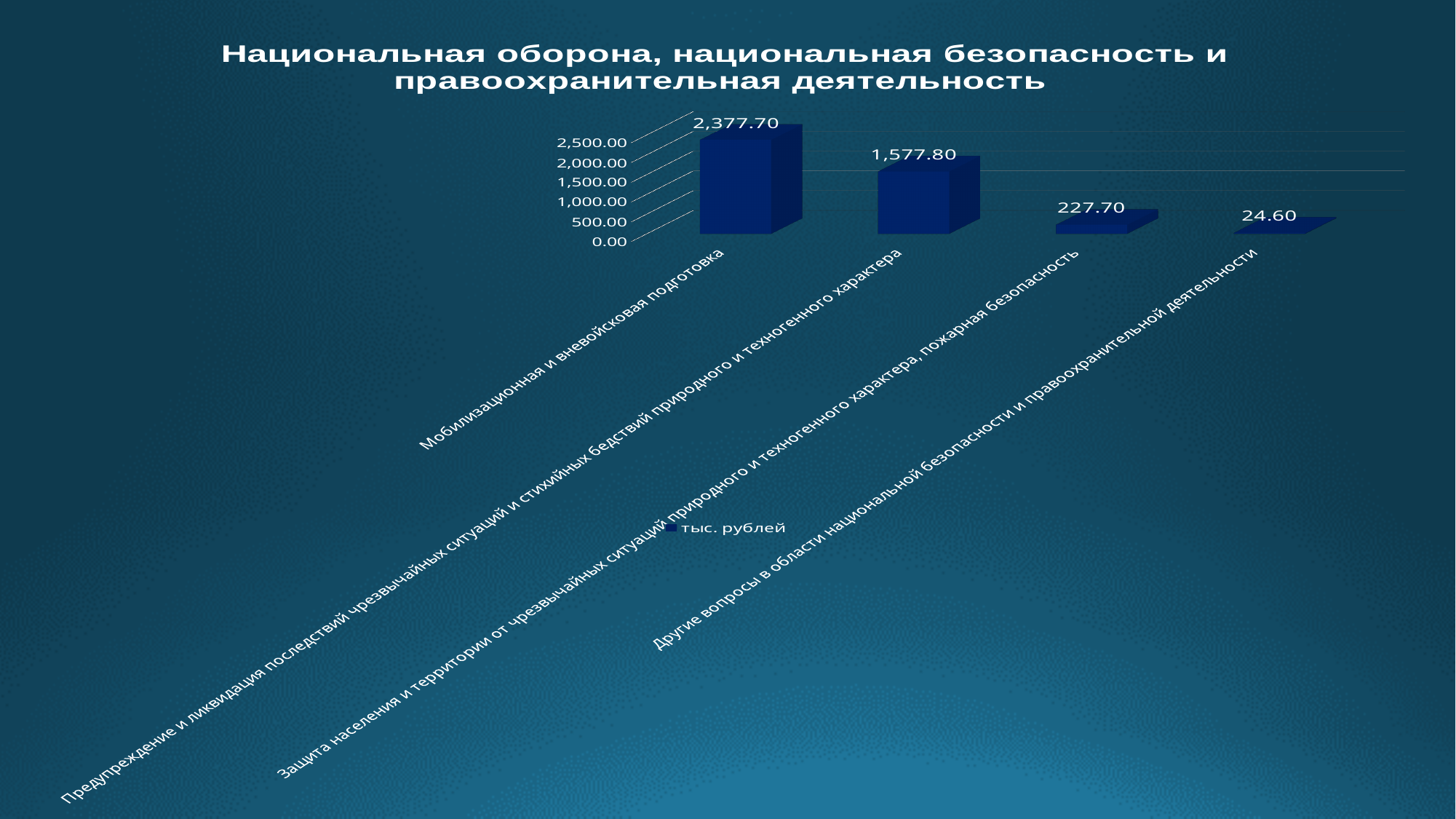
Which category has the highest value? Мобилизационная и вневойсковая подготовка Which is larger: the value for Защита населения и территории от чрезвычайных ситуаций природного и техногенного характера, пожарная безопасность or the value for Другие вопросы в области национальной безопасности и правоохранительной деятельности? Защита населения и территории от чрезвычайных ситуаций природного и техногенного характера, пожарная безопасность What series name does the legend show? тыс. рублей What is the value for Мобилизационная и вневойсковая подготовка? 2,377.70 Which category has the lowest value? Другие вопросы в области национальной безопасности и правоохранительной деятельности What is the value for Другие вопросы в области национальной безопасности и правоохранительной деятельности? 24.60 What is the value for Предупреждение и ликвидация последствий чрезвычайных ситуаций и стихийных бедствий природного и техногенного характера? 1,577.80 What is the difference between the values for Мобилизационная и вневойсковая подготовка and Предупреждение и ликвидация последствий чрезвычайных ситуаций и стихийных бедствий природного и техногенного характера? 799.90 What is the value for Защита населения и территории от чрезвычайных ситуаций природного и техногенного характера, пожарная безопасность? 227.70 What kind of chart is shown on the slide? bar chart How many categories are shown in the chart? 4 Is the value for Предупреждение и ликвидация последствий чрезвычайных ситуаций и стихийных бедствий природного и техногенного характера greater or less than 2,000.00? less